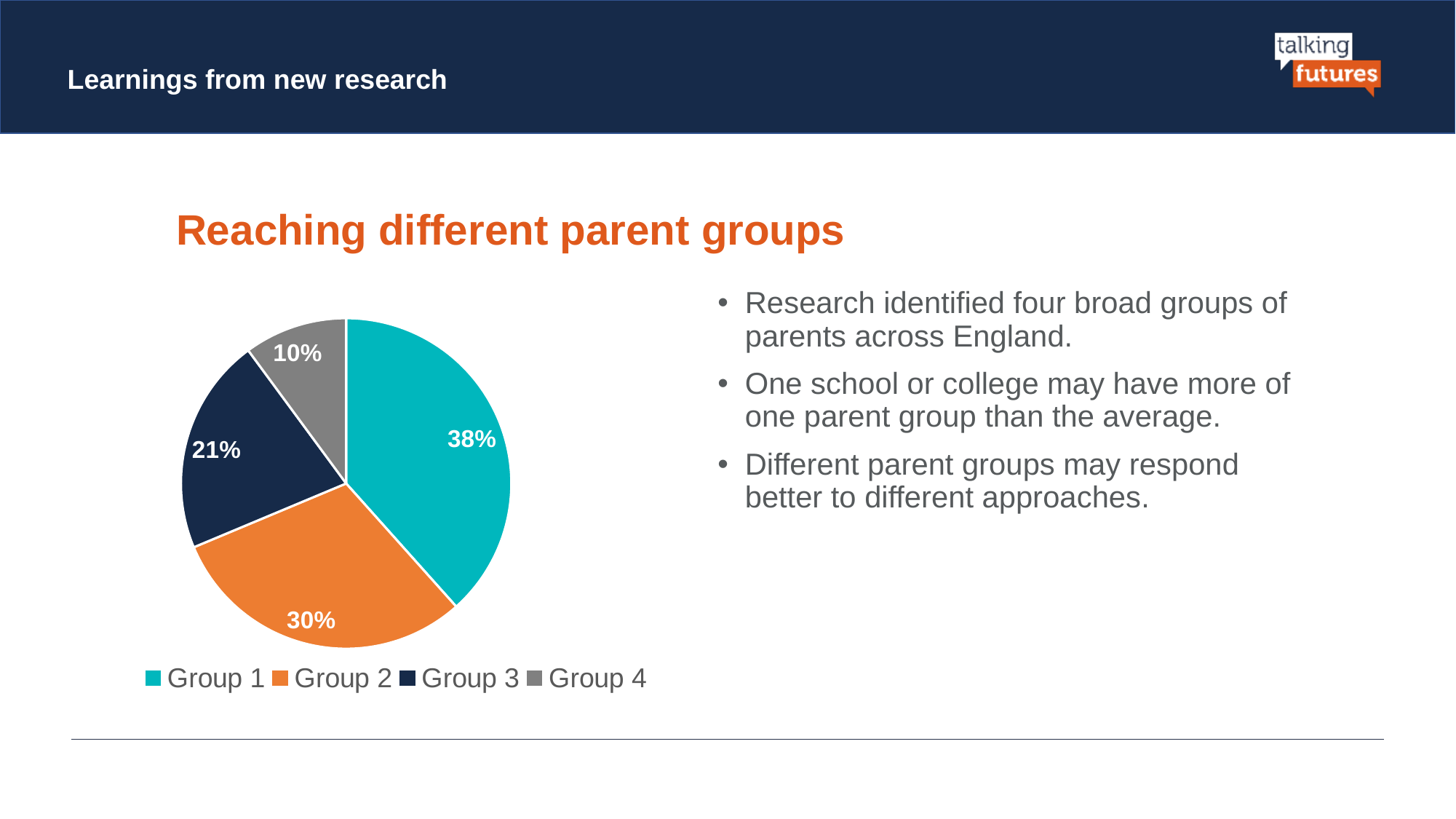
What is the difference in percentage points between Group 1 and Group 2? 8% What share of the pie does Group 2 represent? 30% Which group has the smallest slice of the pie? Group 4 Which group has the largest slice of the pie? Group 1 What kind of chart is shown on the slide? pie chart What share of the pie does Group 4 represent? 10% What share of the pie does Group 3 represent? 21% What colour is the slice for Group 4? grey How many groups are shown in the pie chart? 4 Which is larger, the slice for Group 2 or the slice for Group 3? Group 2 What is the difference in percentage points between Group 3 and Group 4? 11%